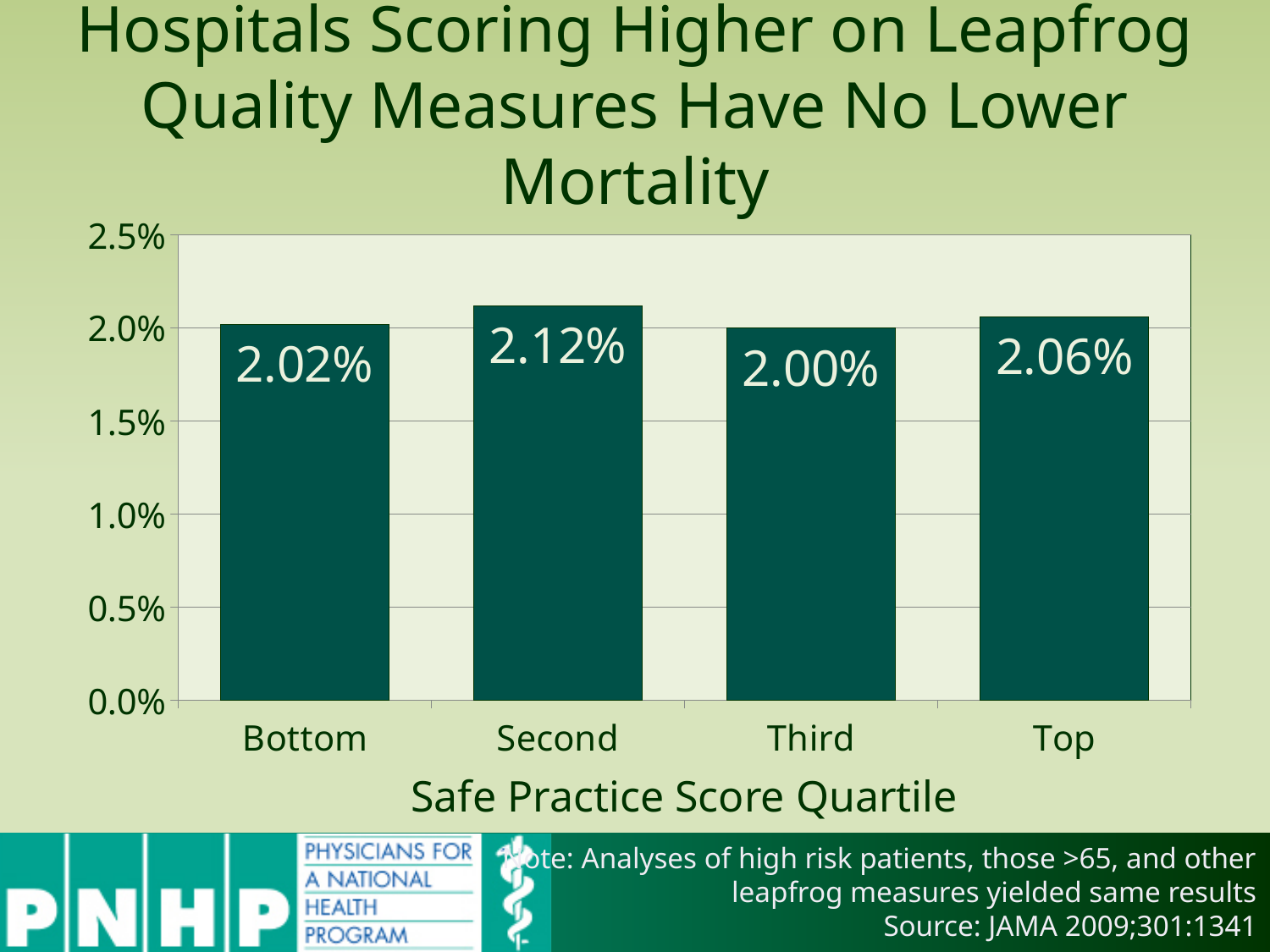
What is the mortality value for the Bottom quartile? 2.02% Which is larger, the value for the Top quartile or the value for the Bottom quartile? Top Which quartile has the highest mortality value? Second Which quartile has the lowest mortality value? Third What is the mortality value for the Top quartile? 2.06% How many quartile categories are shown on the x axis? 4 What is the mortality value for the Third quartile? 2.00% Is the value for the Second quartile greater or less than 2.0%? greater What is the mortality value for the Second quartile? 2.12% What is the x-axis title of the chart? Safe Practice Score Quartile What kind of chart is shown on the slide? bar chart What is the difference between the Second quartile and the Third quartile values? 0.12%